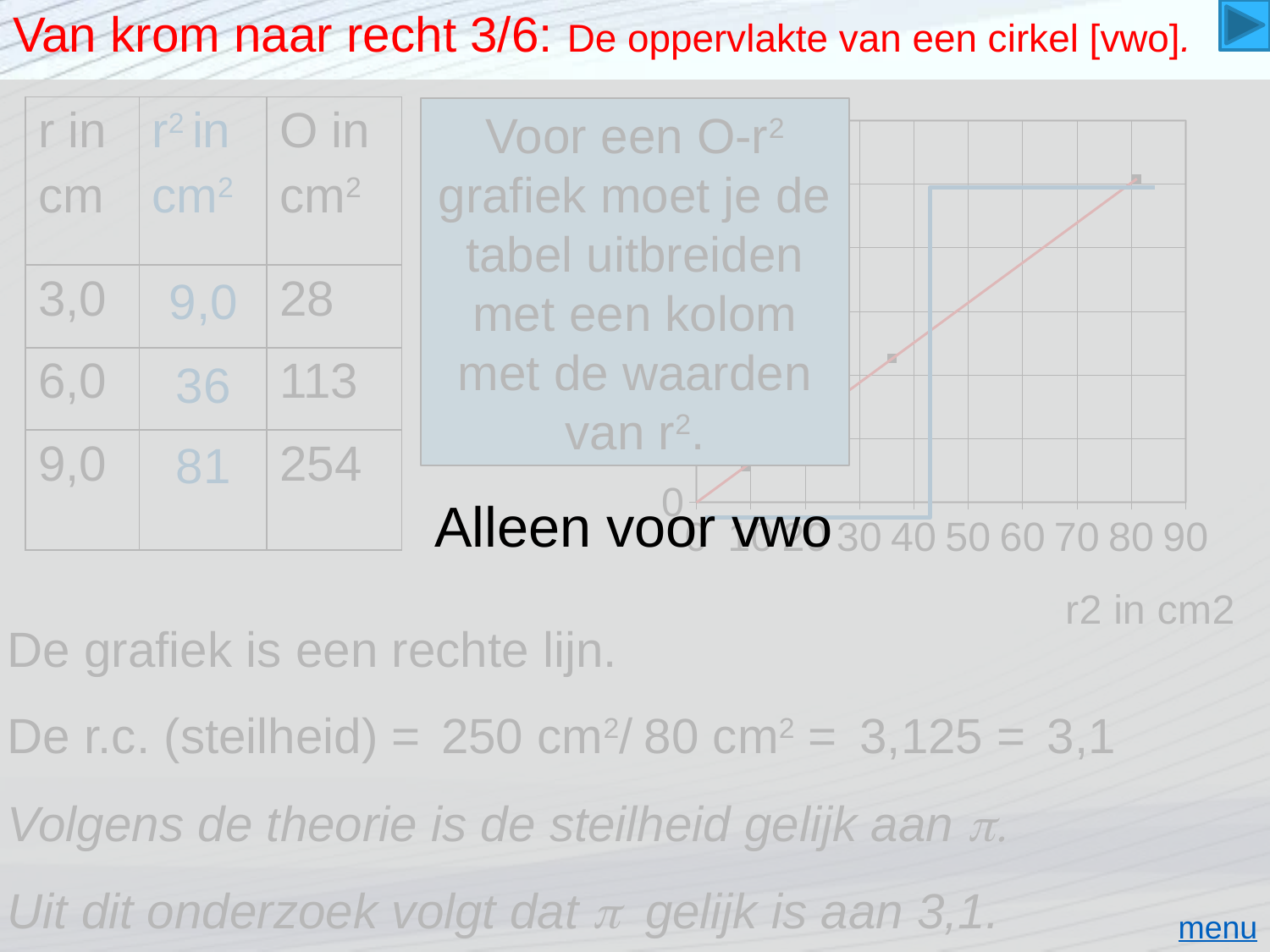
Is the r2 value of the middle plotted point greater or less than 50? less What is the largest tick value shown on the x axis of the chart? 90 Is the r2 value of the middle plotted point greater or less than 30? greater What is the label of the x axis of the chart? r2 in cm2 Which plotted point has the highest value: the leftmost, the middle, or the rightmost? the rightmost Which plotted point has the lowest value: the leftmost, the middle, or the rightmost? the leftmost How many data points are plotted on the chart? 3 Is the r2 value of the rightmost plotted point greater or less than 70? greater What kind of chart is shown on the slide? line chart Do the plotted values rise or fall as r2 increases along the x axis? rise